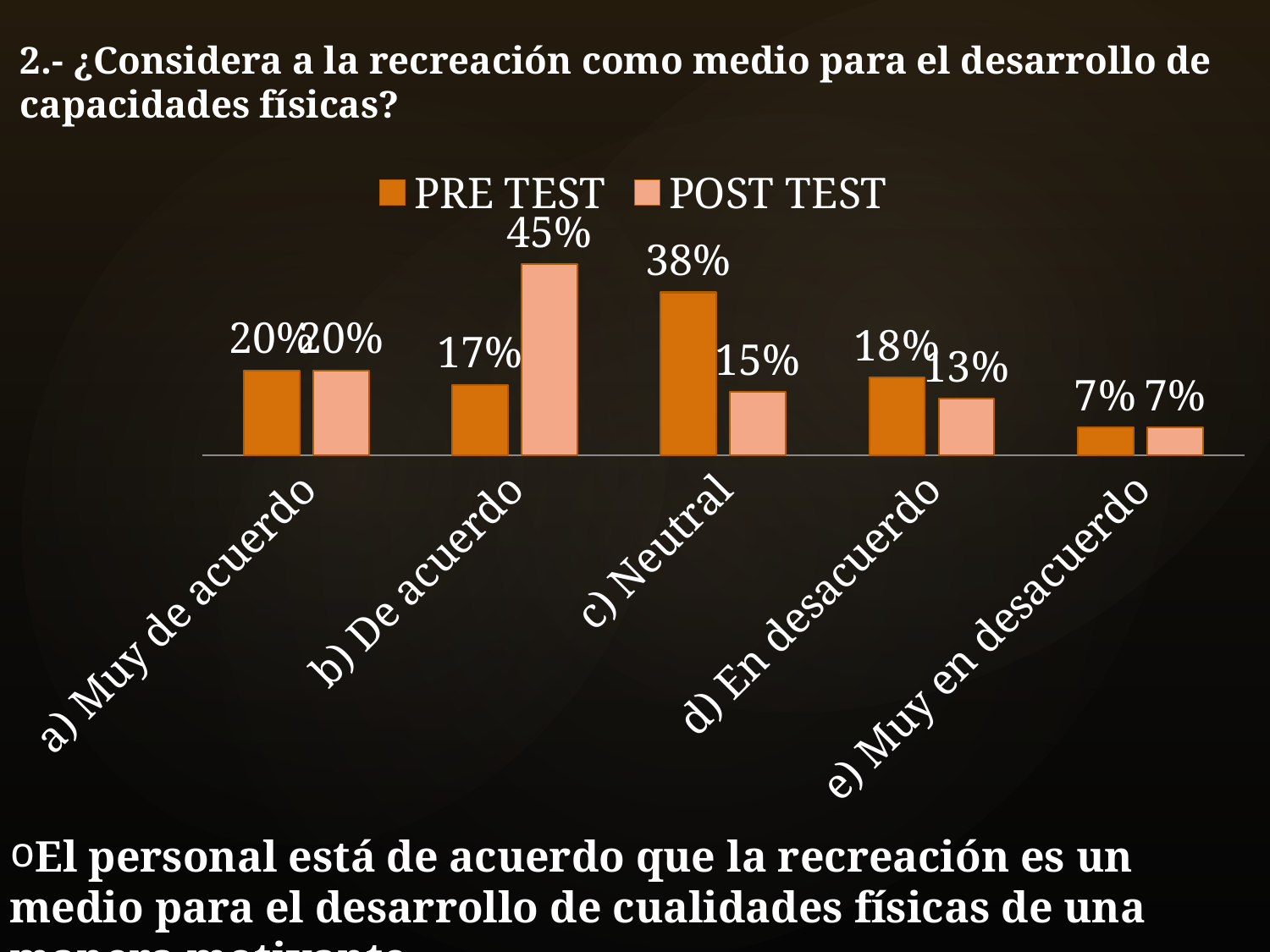
What is the POST TEST value for e) Muy en desacuerdo? 7% What kind of chart is shown on the slide? Bar chart What is the difference between the POST TEST and PRE TEST values for b) De acuerdo? 28% What is the POST TEST value for b) De acuerdo? 45% What is the PRE TEST value for c) Neutral? 38% Which category has the highest POST TEST value? b) De acuerdo What is the difference between the PRE TEST and POST TEST values for c) Neutral? 23% What is the PRE TEST value for d) En desacuerdo? 18% How many categories are shown on the x axis? 5 Which category has the lowest PRE TEST value? e) Muy en desacuerdo Which is larger for d) En desacuerdo, the PRE TEST value or the POST TEST value? PRE TEST How many series does the legend list? 2